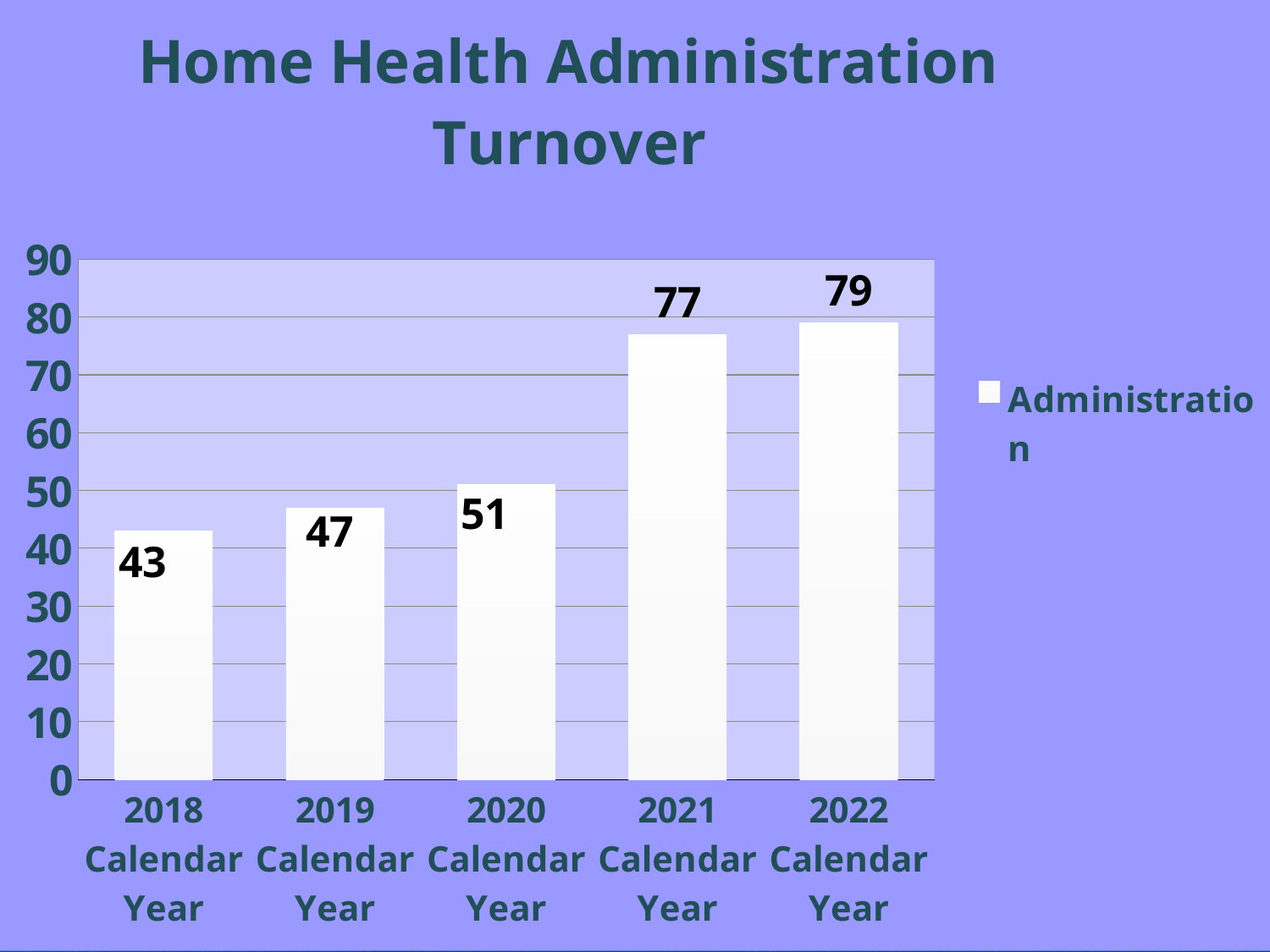
What is the difference between the Administration turnover in 2021 and 2020? 26 What is the difference between the Administration turnover in 2022 and 2018? 36 What kind of chart is shown on the slide? Bar chart Is the Administration turnover for 2022 greater or less than 70? greater Which is larger, the Administration turnover for 2019 or for 2020? 2020 Which calendar year has the highest Administration turnover? 2022 Calendar Year How many calendar years are shown on the chart? 5 What is the Administration turnover value for 2020 Calendar Year? 51 Which calendar year has the lowest Administration turnover? 2018 Calendar Year What is the Administration turnover value for 2018 Calendar Year? 43 Does the Administration turnover rise or fall from 2018 to 2022? Rise What is the Administration turnover value for 2021 Calendar Year? 77